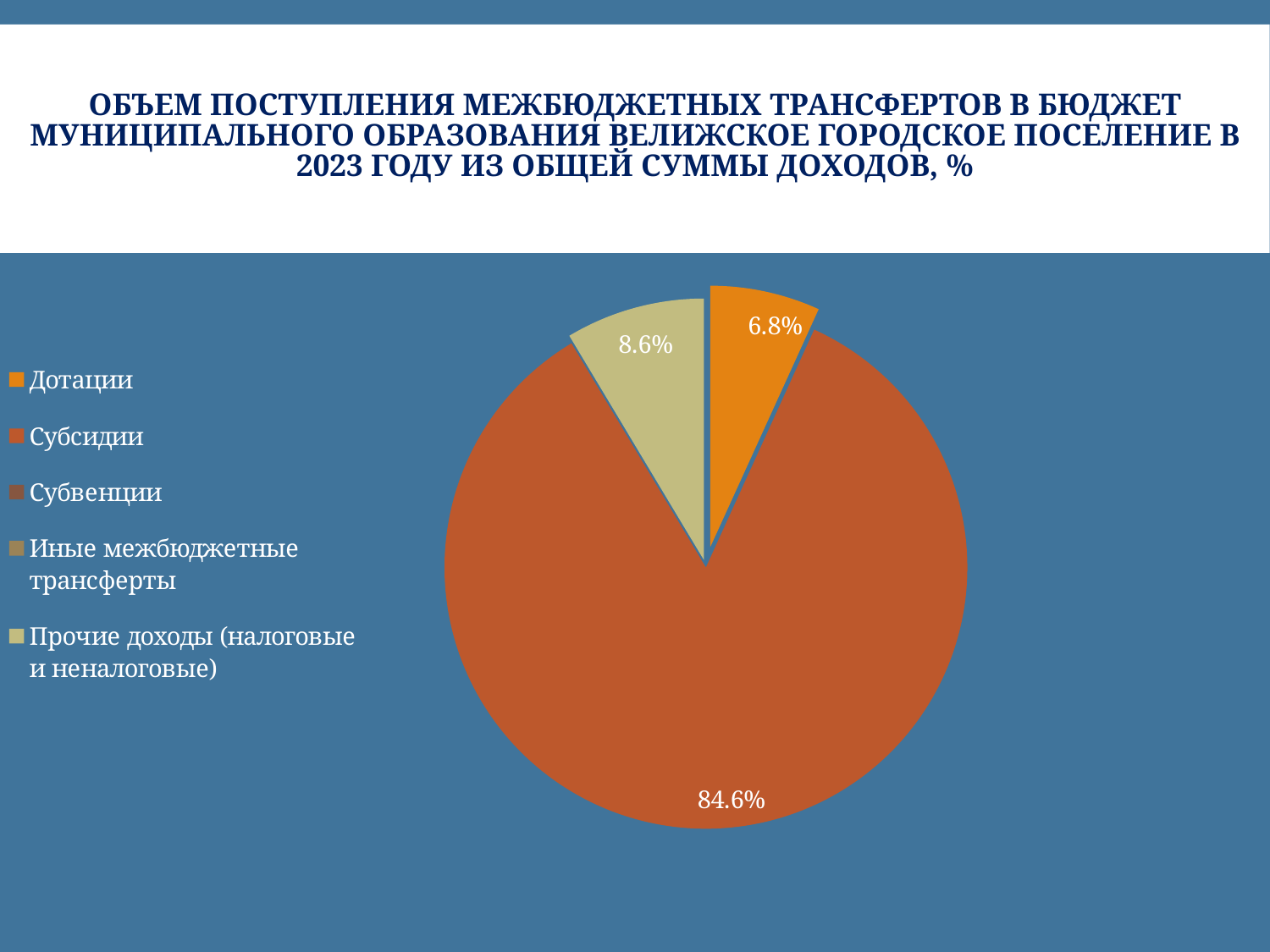
Is the share for Субсидии greater or less than 50%? greater What kind of chart is shown on the slide? pie chart What percentage is shown for Прочие доходы (налоговые и неналоговые)? 8.6% How many categories does the legend list? 5 Which category has the largest slice of the pie? Субсидии Which is larger, the Дотации slice or the Прочие доходы slice? Прочие доходы What is the difference between the Прочие доходы share and the Дотации share? 1.8% What percentage is shown for Дотации? 6.8% What percentage is shown for Субсидии? 84.6% How many slices of the pie have a data label? 3 What is the difference between the Субсидии share and the Прочие доходы share? 76.0% Which of the labelled slices is the smallest? Дотации